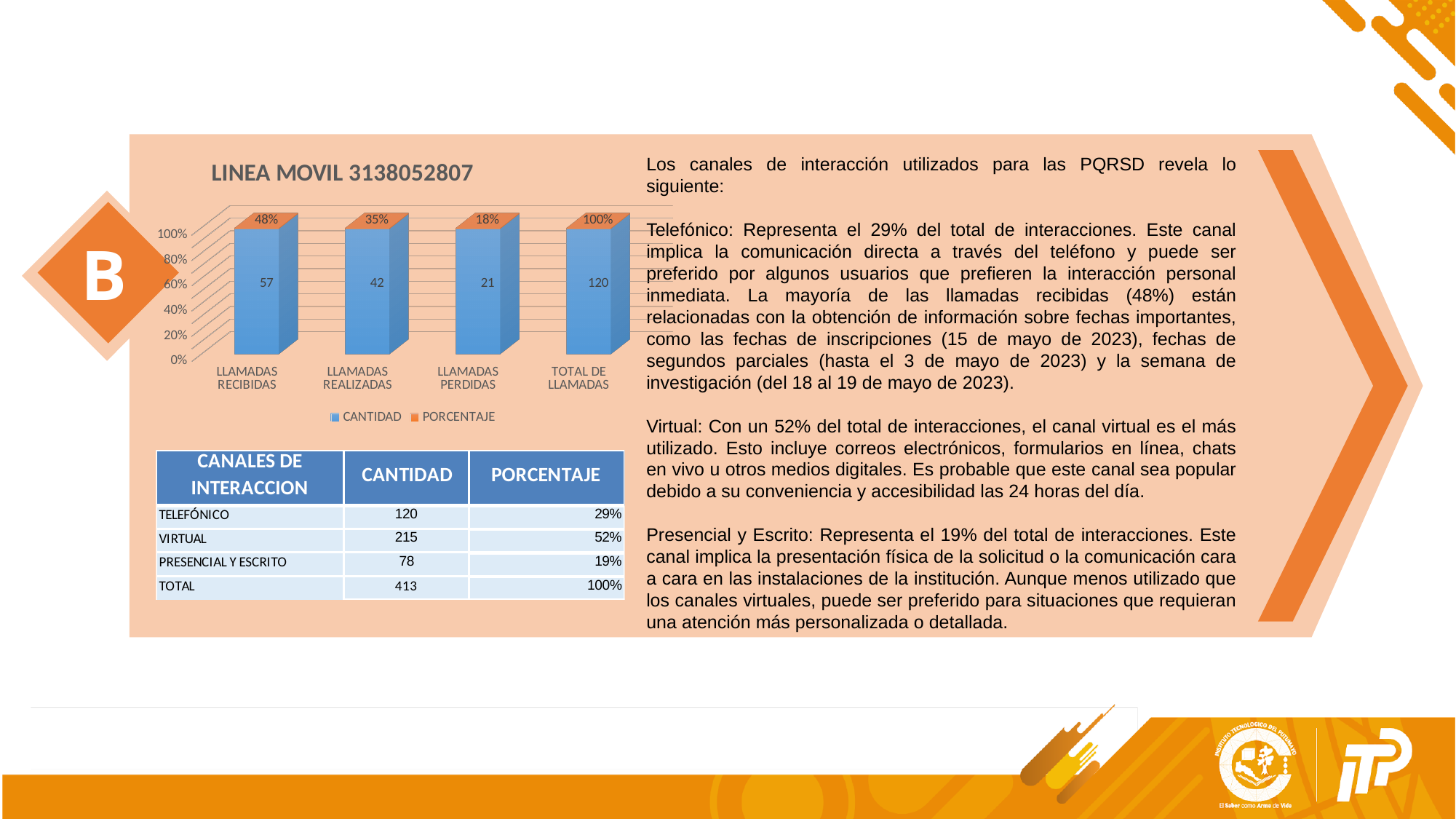
What is the PORCENTAJE value for LLAMADAS RECIBIDAS? 48% What type of chart is shown on the slide? bar chart How many series does the chart legend list? 2 What is the difference between the CANTIDAD values for LLAMADAS RECIBIDAS and LLAMADAS REALIZADAS? 15 Which series is shown in orange in the chart? PORCENTAJE What is the CANTIDAD value for LLAMADAS PERDIDAS? 21 Which category has the highest CANTIDAD value? TOTAL DE LLAMADAS Which category has the lowest CANTIDAD value? LLAMADAS PERDIDAS What is the PORCENTAJE value for LLAMADAS REALIZADAS? 35% How many categories are shown on the x axis of the chart? 4 What is the CANTIDAD value for LLAMADAS RECIBIDAS? 57 What is the title of the chart? LINEA MOVIL 3138052807